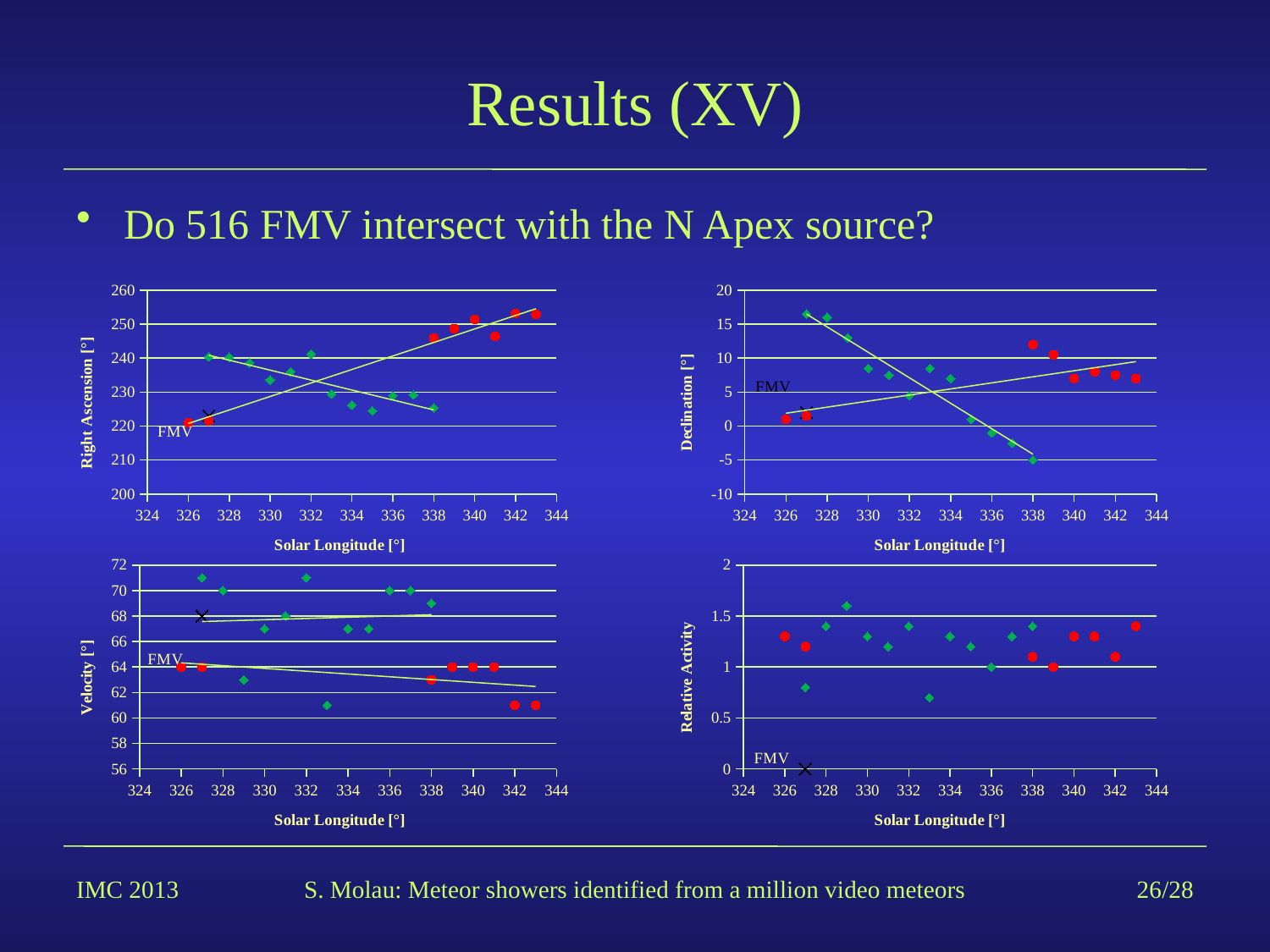
In the top-left chart, what is the title of the vertical axis? Right Ascension [°] In the bottom-left chart (Velocity), is the red point at solar longitude 342 greater or less than 62? less In the top-right chart (Declination), is the red point at solar longitude 338 greater or less than 10? greater How many charts are shown on the slide? 4 What kind of chart is the top-left chart (Right Ascension vs Solar Longitude)? scatter chart In the top-right chart (Declination), is the green point at solar longitude 338 greater or less than 0? less In the top-right chart (Declination), do the green points rise or fall as solar longitude increases? fall In the top-right chart, what is the title of the vertical axis? Declination [°] In the top-left chart (Right Ascension), do the red points rise or fall as solar longitude increases? rise